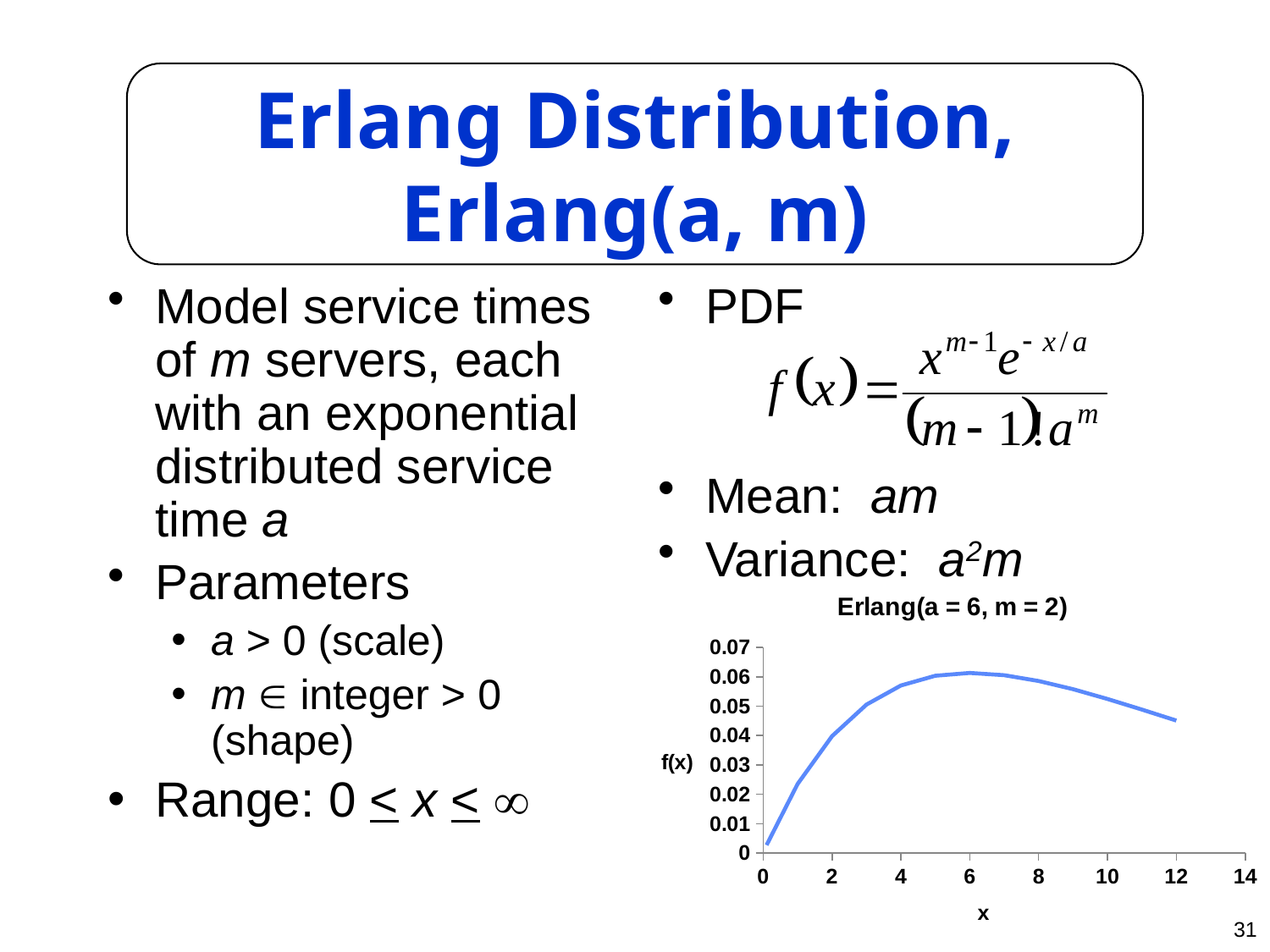
Is the value of f(x) at x = 0 greater or less than 0.01? less Which is larger, f(x) at x = 2 or f(x) at x = 10? x = 10 What kind of chart is shown on the slide? line chart What is the title of the chart? Erlang(a = 6, m = 2) Is the value of f(x) at x = 1 greater or less than 0.03? less Which is larger, f(x) at x = 6 or f(x) at x = 12? x = 6 Does the curve rise or fall as x increases from 0 to 4? rise Is the value of f(x) at x = 12 greater or less than 0.05? less What label is on the vertical axis of the chart? f(x)